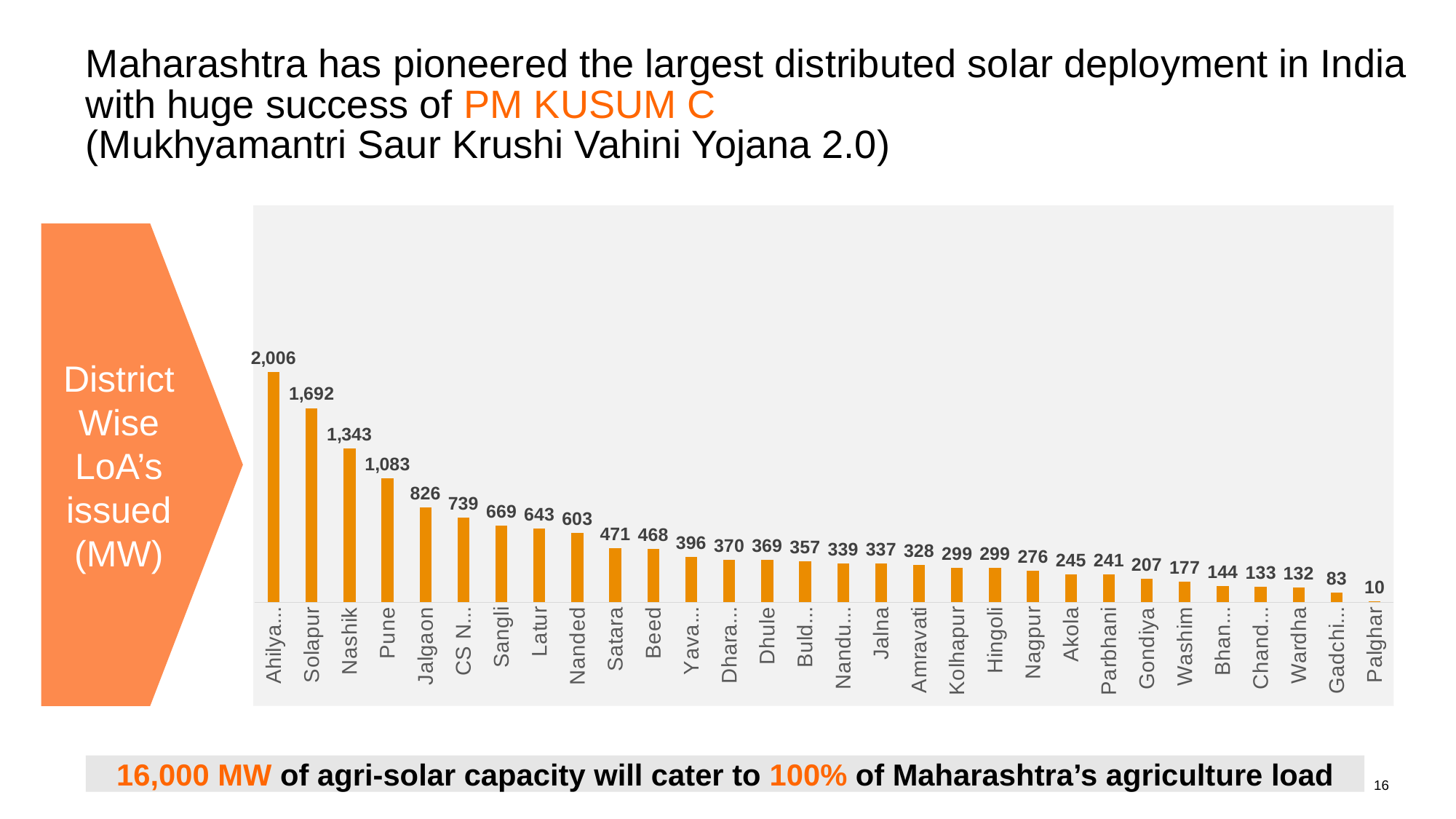
What is the highest value shown in the chart? 2,006 Which is larger, the value for Wardha or the value for Akola? Akola What kind of chart is shown on the slide? Bar chart What is the difference between the values for Nashik and Pune? 260 What is the difference between the values for Jalgaon and Sangli? 157 What is the value for Kolhapur in the chart? 299 What is the value for Nanded in the chart? 603 How many districts are shown in the chart? 30 What is the value for Pune in the chart? 1,083 What is the value for Solapur in the District Wise LoA's issued (MW) chart? 1,692 Which district has the lowest value in the chart? Palghar Which is larger, the value for Satara or the value for Nagpur? Satara